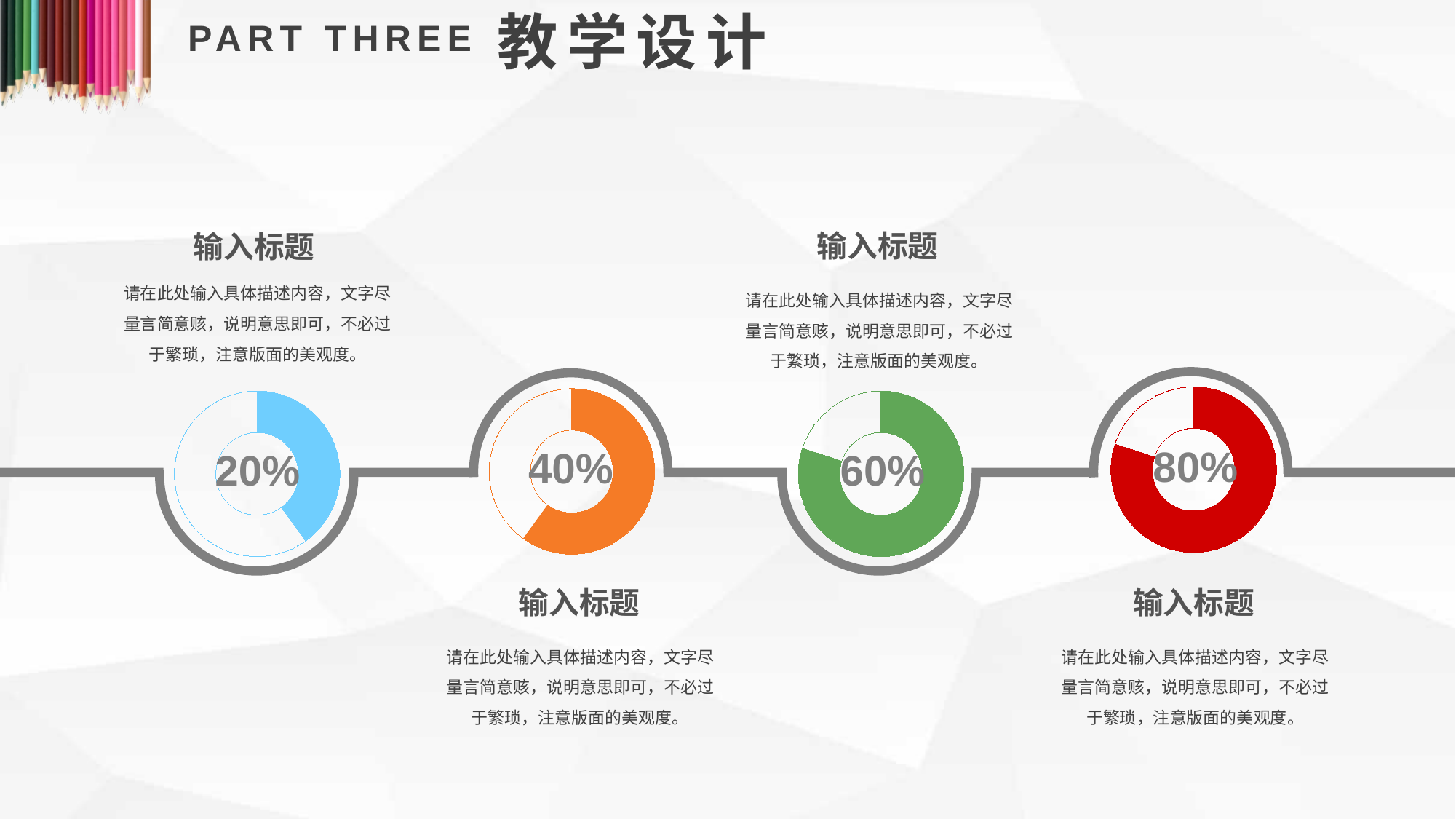
What is the difference between the value in the green donut chart and the value in the orange donut chart? 20% Which of the four donut charts shows the highest value? The red chart on the far right (80%) What value is shown in the green donut chart, third from the left? 60% Which of the four donut charts shows the lowest value? The blue chart on the far left (20%) How many donut charts are on the slide? 4 Which is larger, the value in the orange donut chart or the value in the green donut chart? The green donut chart (60%) What value is shown in the orange donut chart, second from the left? 40% What value is shown in the red donut chart on the far right? 80% What kind of chart is used for each of the four percentage figures on the slide? Donut (ring) chart What is the difference between the value in the red donut chart and the value in the blue donut chart? 60% Do the values in the donut charts rise or fall from left to right across the slide? Rise What value is shown in the blue donut chart on the far left? 20%